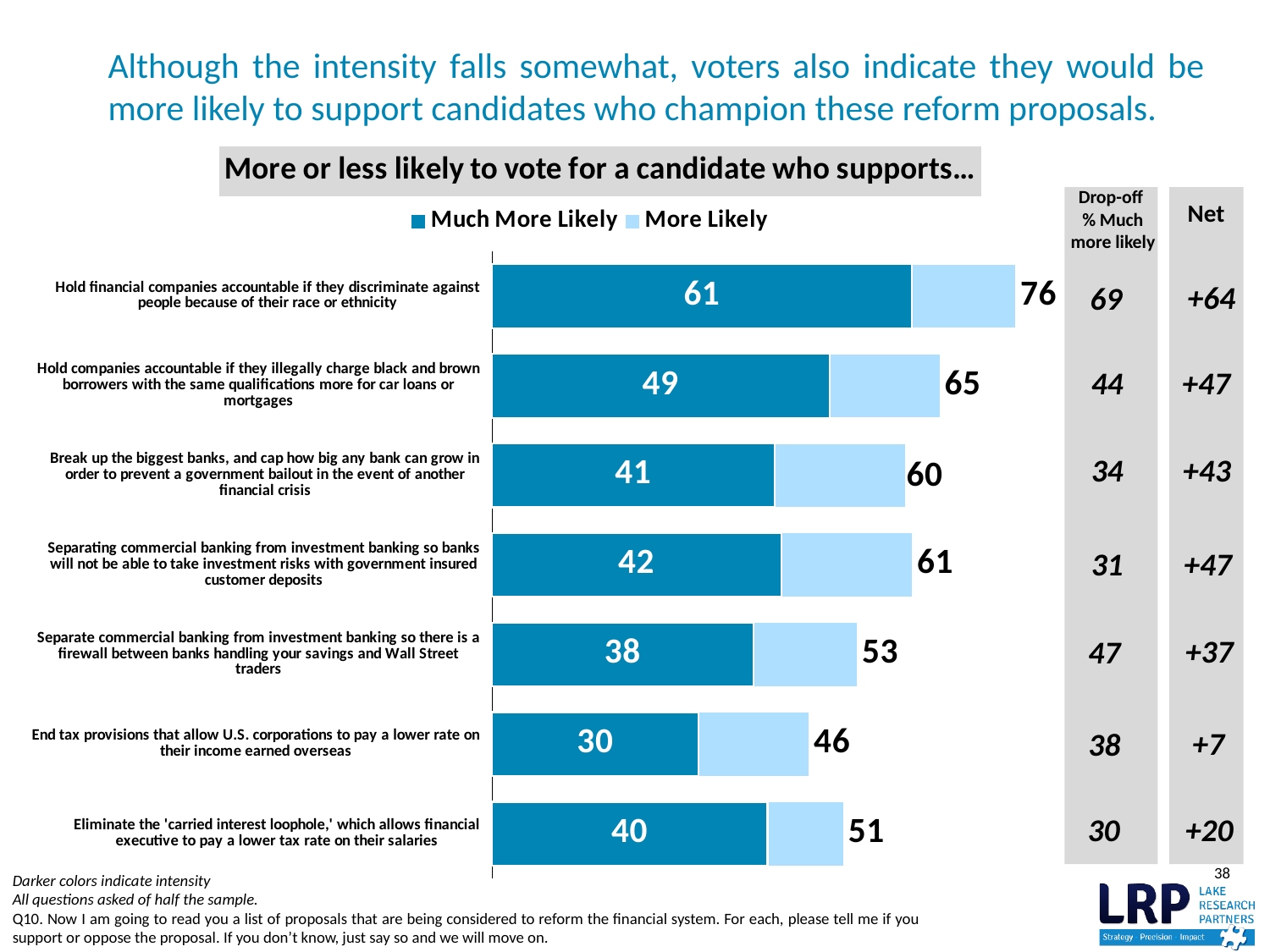
Which has a larger total bar: 'Separate commercial banking from investment banking so there is a firewall between banks handling your savings and Wall Street traders' or 'Eliminate the carried interest loophole'? Separate commercial banking from investment banking so there is a firewall between banks handling your savings and Wall Street traders Which proposal has the lowest 'Much More Likely' value? End tax provisions that allow U.S. corporations to pay a lower rate on their income earned overseas Which proposal has the highest 'Much More Likely' value? Hold financial companies accountable if they discriminate against people because of their race or ethnicity What is the total bar value for 'Hold companies accountable if they illegally charge black and brown borrowers with the same qualifications more for car loans or mortgages'? 65 How many series does the chart legend list? 2 What is the total (Much More Likely plus More Likely) for 'Break up the biggest banks, and cap how big any bank can grow in order to prevent a government bailout in the event of another financial crisis'? 60 What kind of chart is shown on the slide? Stacked bar chart What is the difference between the 'Much More Likely' values for 'Hold financial companies accountable if they discriminate against people because of their race or ethnicity' (61) and 'Hold companies accountable if they illegally charge black and brown borrowers with the same qualifications more for car loans or mortgages' (49)? 12 What is the 'Much More Likely' value for 'End tax provisions that allow U.S. corporations to pay a lower rate on their income earned overseas'? 30 How many proposals (categories) are plotted in the chart? 7 What is the 'Much More Likely' value for 'Hold financial companies accountable if they discriminate against people because of their race or ethnicity'? 61 What are the two legend entries of the chart? Much More Likely and More Likely